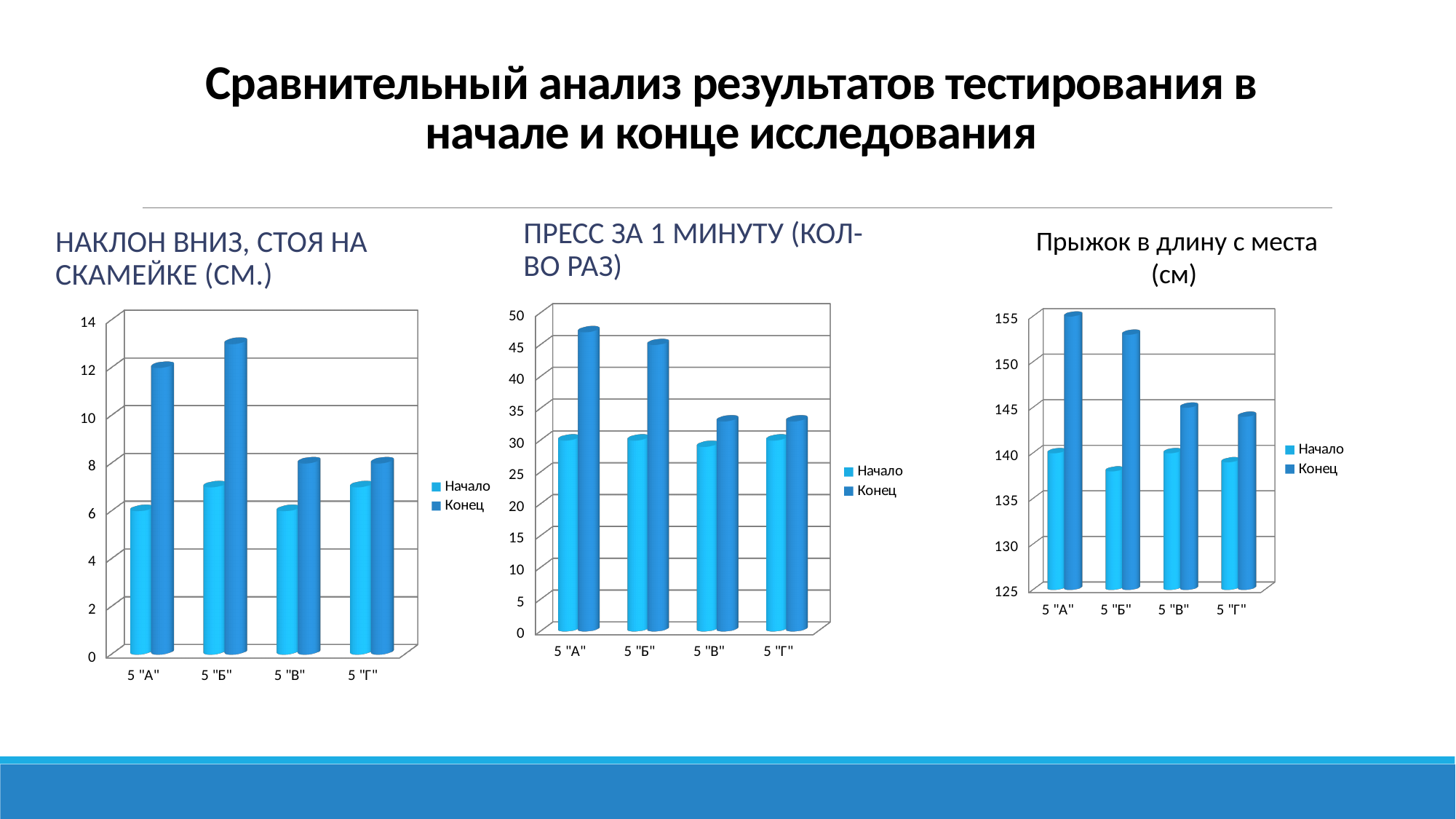
On the chart "Пресс за 1 минуту (кол-во раз)", how many series does the legend list? 2 On the chart "Пресс за 1 минуту (кол-во раз)", is the "Конец" value for 5 "В" greater or less than 35? less On the chart "Наклон вниз, стоя на скамейке (см.)", how many classes are shown on the x axis? 4 On the chart "Наклон вниз, стоя на скамейке (см.)", is the "Конец" value for 5 "А" greater or less than 10? greater What kind of chart is "Прыжок в длину с места (см)"? bar chart On the chart "Прыжок в длину с места (см)", which class has the highest value for the "Конец" series? 5 "А" On the chart "Пресс за 1 минуту (кол-во раз)", which is larger: the "Конец" value for 5 "Б" or the "Конец" value for 5 "Г"? 5 "Б" On the chart "Наклон вниз, стоя на скамейке (см.)", which class has the highest value for the "Конец" series? 5 "Б" On the chart "Прыжок в длину с места (см)", is the "Начало" value for 5 "Б" greater or less than 140? less On the chart "Наклон вниз, стоя на скамейке (см.)", what are the two series named in the legend? Начало and Конец On the chart "Наклон вниз, стоя на скамейке (см.)", which is larger: the "Конец" value for 5 "А" or the "Конец" value for 5 "В"? 5 "А"